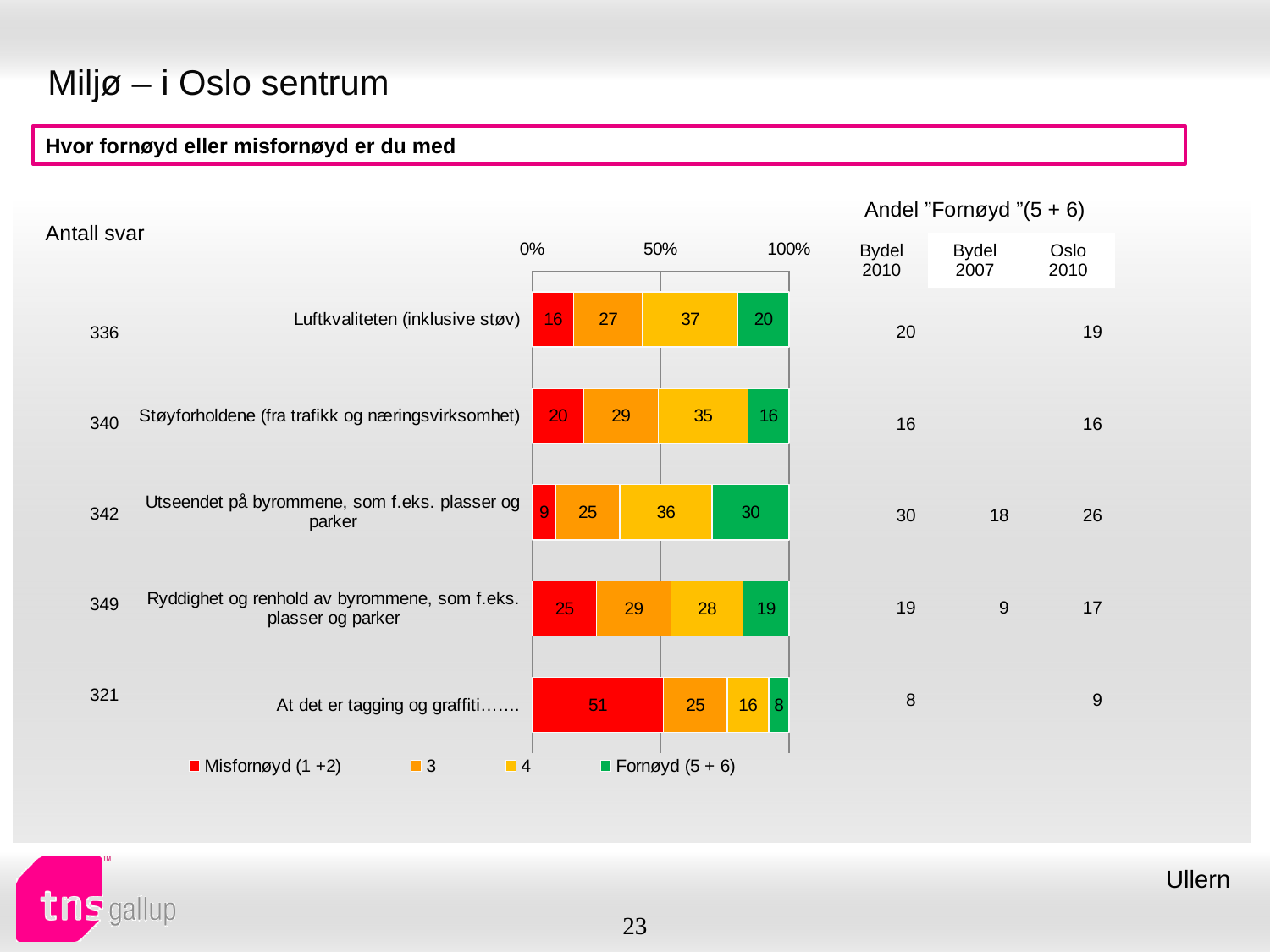
Which category has the lowest Misfornøyd (1 +2) value? Utseendet på byrommene, som f.eks. plasser og parker What is the total of the stacked bar for Utseendet på byrommene, som f.eks. plasser og parker? 100 What is the value of the Fornøyd (5 + 6) segment for Luftkvaliteten (inklusive støv)? 20 Which colour represents the Fornøyd (5 + 6) series in the legend? Green What is the difference between the Misfornøyd (1 +2) values for At det er tagging og graffiti and Ryddighet og renhold av byrommene? 26 What type of chart is shown on the slide? Stacked bar chart How many series does the chart legend list? 4 Which category has the highest Fornøyd (5 + 6) value? Utseendet på byrommene, som f.eks. plasser og parker What is the value of the '4' segment for Støyforholdene (fra trafikk og næringsvirksomhet)? 35 What is the value of the Misfornøyd (1 +2) segment for At det er tagging og graffiti? 51 Which is larger: the Fornøyd (5 + 6) value for Luftkvaliteten (inklusive støv) or for Ryddighet og renhold av byrommene? Luftkvaliteten (inklusive støv) How many categories (statements) are plotted in the chart? 5